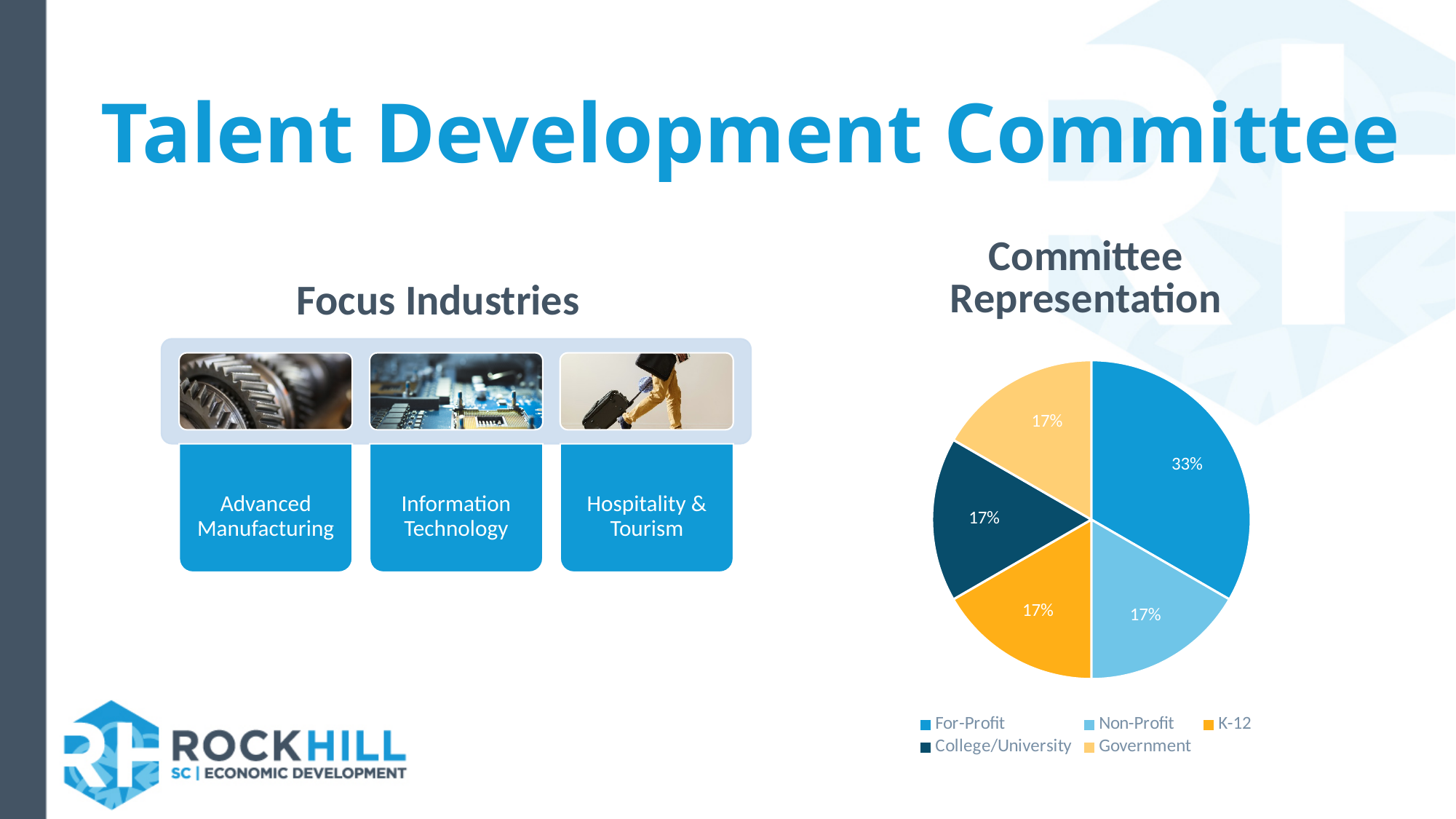
What share of the committee is For-Profit? 33% What is the difference in percentage points between the For-Profit and Non-Profit slices? 16% What share of the committee is K-12? 17% How many entries does the legend of the pie chart list? 5 What type of chart is shown under the title "Committee Representation"? pie chart Which category has the largest slice of the pie chart? For-Profit What share of the committee is College/University? 17% Which is larger, the For-Profit slice or the Government slice? For-Profit How many slices does the pie chart have? 5 What share of the committee is Non-Profit? 17% What share of the committee is Government? 17% What is the title of the pie chart? Committee Representation